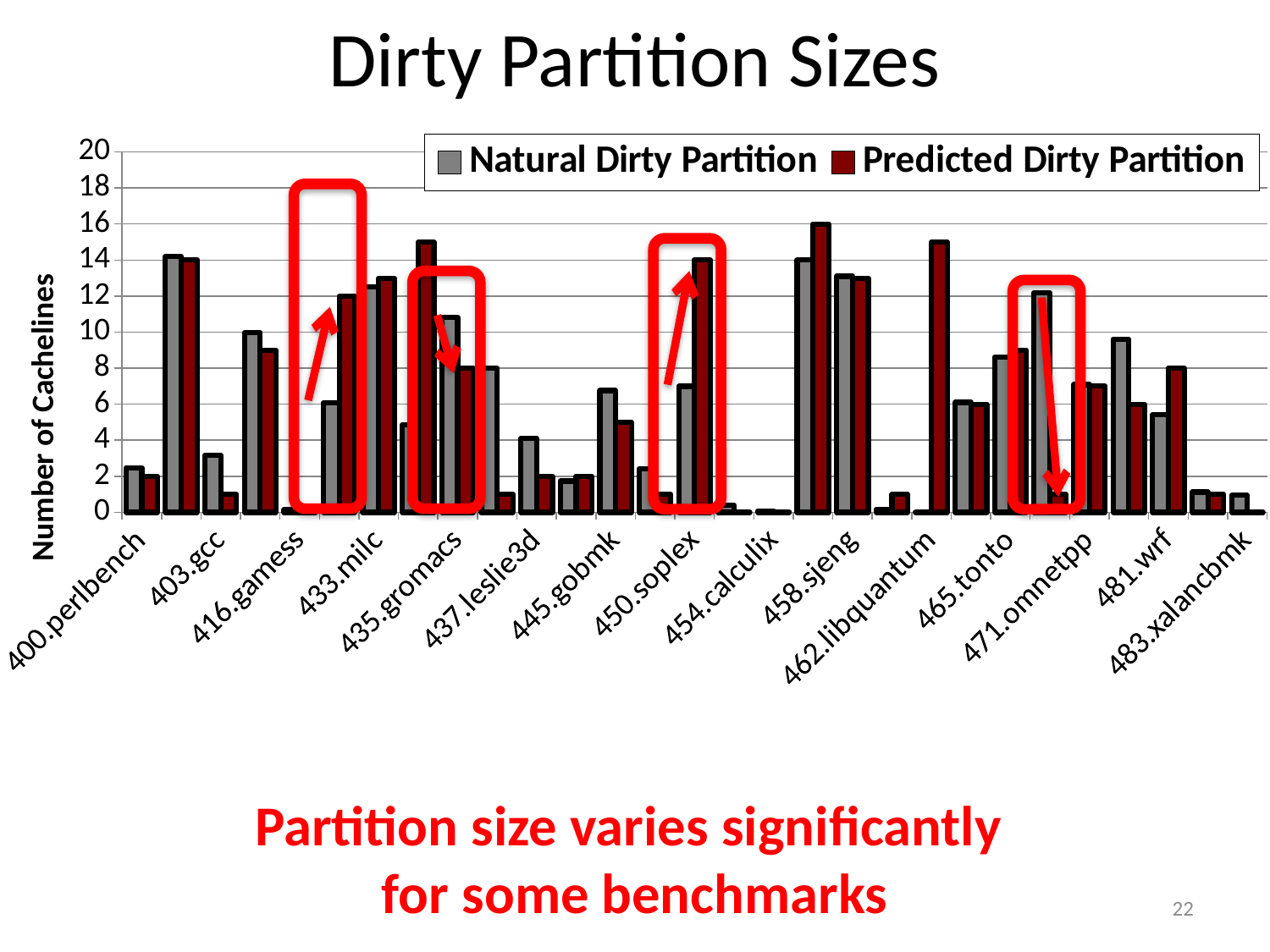
For 435.gromacs, which is larger: the Natural Dirty Partition or the Predicted Dirty Partition? Natural Dirty Partition What kind of chart is shown on the slide? bar chart Is the Natural Dirty Partition value for 450.soplex greater or less than 10? less Is the Natural Dirty Partition value for 433.milc greater or less than 10? greater Is the Predicted Dirty Partition value for 450.soplex greater or less than 10? greater What are the two series named in the legend? Natural Dirty Partition and Predicted Dirty Partition For 462.libquantum, which is larger: the Natural Dirty Partition or the Predicted Dirty Partition? Predicted Dirty Partition How many series does the legend list? 2 What is the label of the vertical axis? Number of Cachelines For 450.soplex, which is larger: the Natural Dirty Partition or the Predicted Dirty Partition? Predicted Dirty Partition